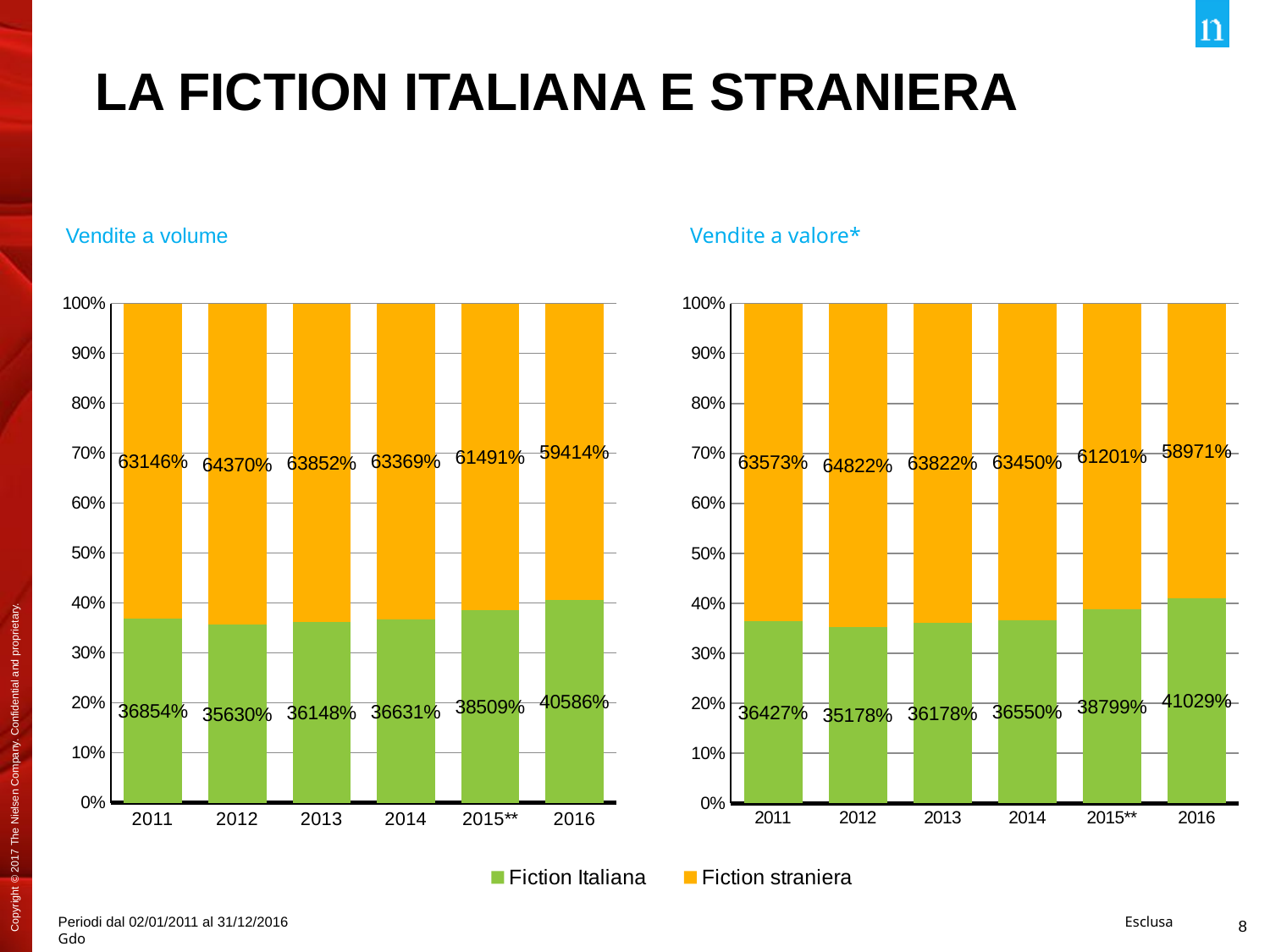
In the 'Vendite a volume' chart, what is the difference between the Fiction Italiana values for 2016 and 2011? 3732% How many years are shown on the x axis of the 'Vendite a volume' chart? 6 In the 'Vendite a valore*' chart, what is the value for Fiction straniera in 2012? 64822% In the 'Vendite a volume' chart, in which year is the Fiction Italiana value lowest? 2012 What kind of chart is the 'Vendite a valore*' chart? Stacked bar chart In the 'Vendite a volume' chart, what is the value for Fiction Italiana in 2016? 40586% In the 'Vendite a valore*' chart, in which year is the Fiction Italiana value highest? 2016 In the 'Vendite a volume' chart, what is the value for Fiction straniera in 2015**? 61491% How many series does the legend list? 2 In the 'Vendite a valore*' chart, in which year is the Fiction straniera value lowest? 2016 In the 'Vendite a volume' chart, does the Fiction Italiana value rise or fall from 2013 to 2016? Rise In the 'Vendite a valore*' chart, which is larger: the Fiction Italiana value for 2015** or for 2014? 2015**